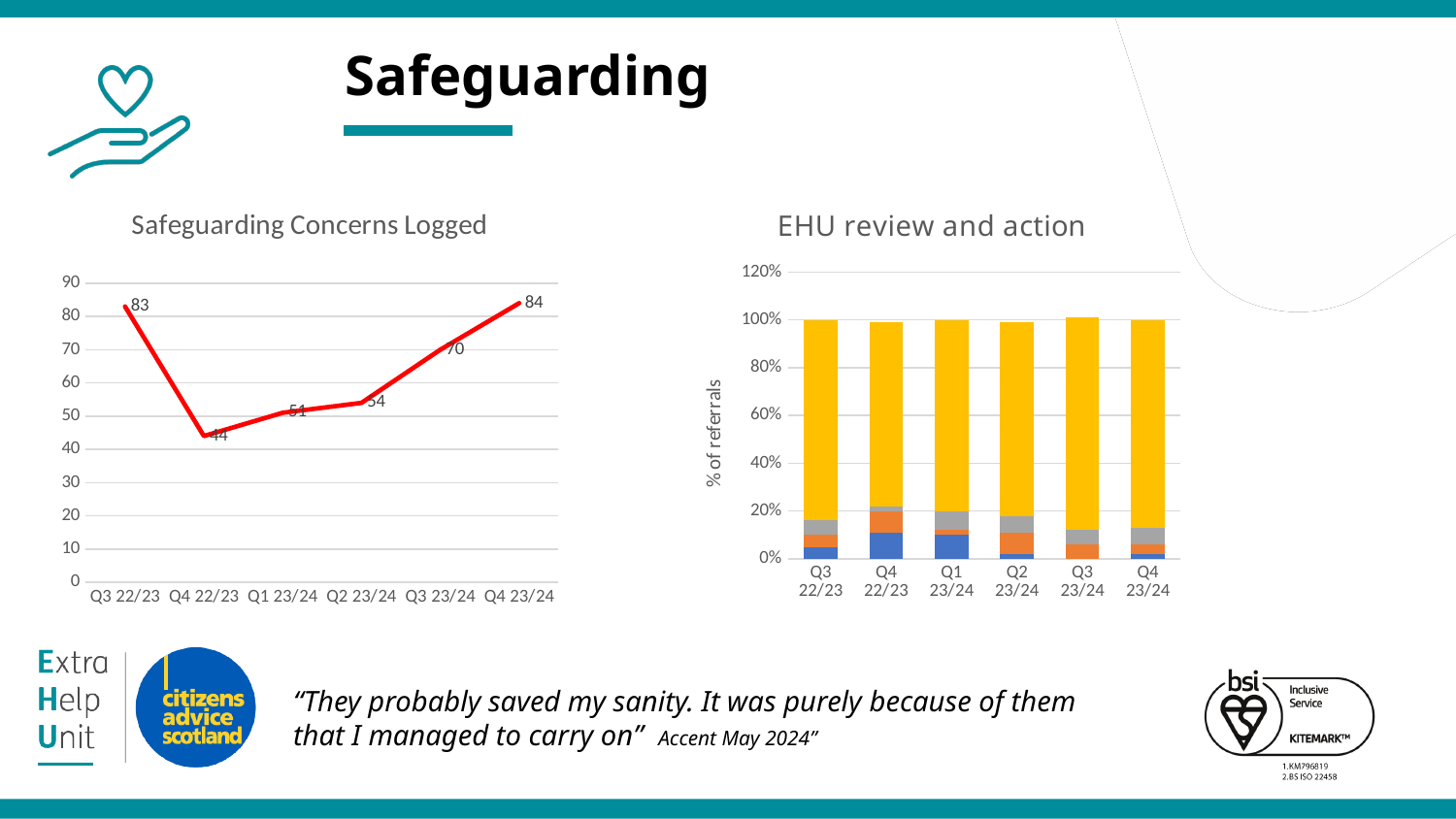
In the Safeguarding Concerns Logged chart, how many quarters are plotted? 6 In the Safeguarding Concerns Logged chart, what is the difference between the values for Q3 23/24 and Q2 23/24? 16 What kind of chart is the EHU review and action chart? Stacked bar chart In the Safeguarding Concerns Logged chart, which quarter has the lowest value? Q4 22/23 In the Safeguarding Concerns Logged chart, which quarter has the highest value? Q4 23/24 In the Safeguarding Concerns Logged chart, do the values rise or fall from Q4 22/23 to Q4 23/24? Rise In the Safeguarding Concerns Logged chart, which is larger, the value for Q4 22/23 or the value for Q2 23/24? Q2 23/24 In the EHU review and action chart, how many quarters are shown on the x axis? 6 In the EHU review and action chart, what is the label on the vertical axis? % of referrals In the Safeguarding Concerns Logged chart, what is the value for Q3 22/23? 83 What kind of chart is the Safeguarding Concerns Logged chart? Line chart In the Safeguarding Concerns Logged chart, what is the value for Q1 23/24? 51